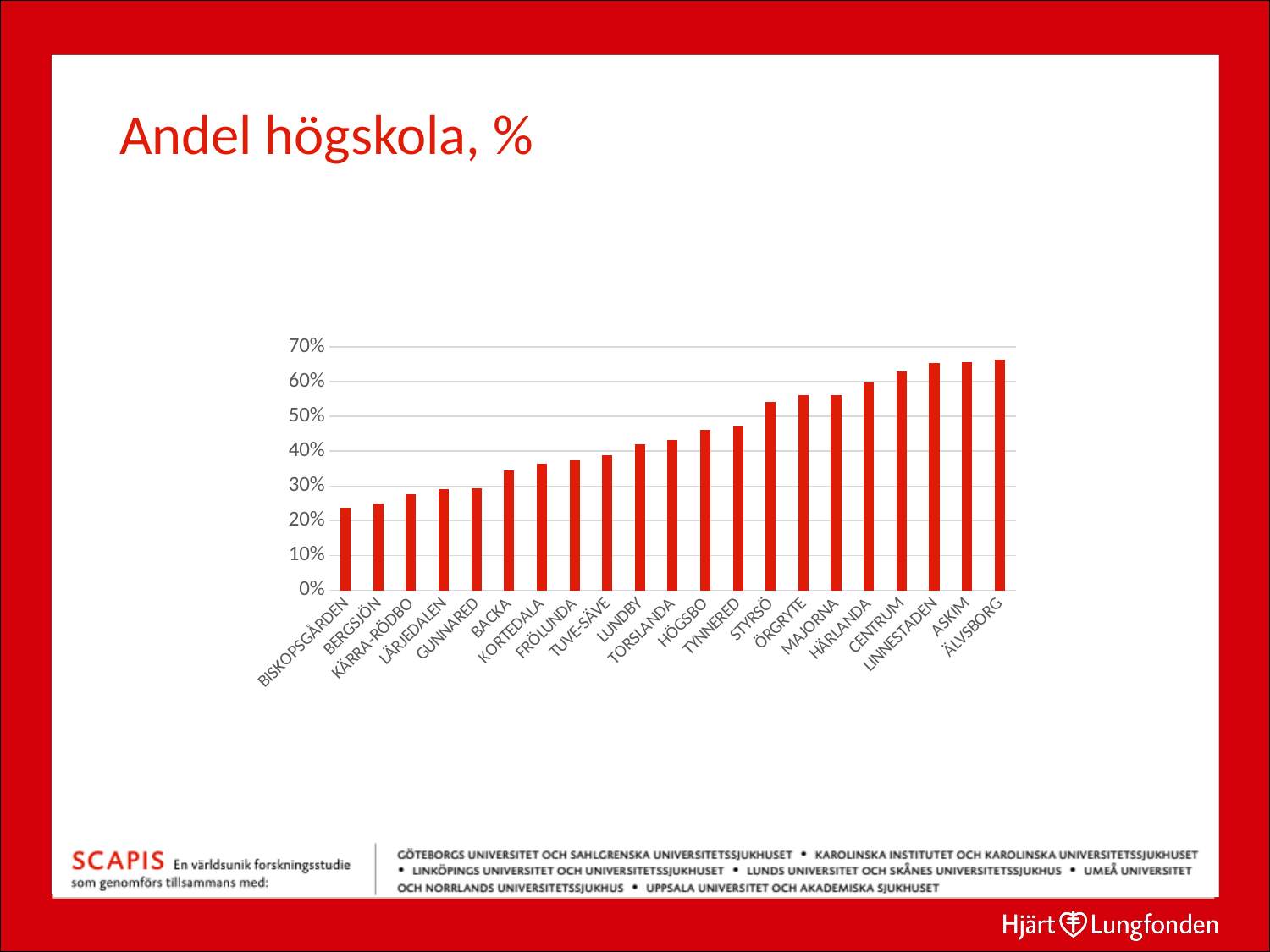
How many districts (bars) are shown in the chart? 21 Is the value for Tynnered greater or less than 50%? less What is the title of the chart? Andel högskola, % Is the value for Styrsö greater or less than 50%? greater What kind of chart is shown on the slide? Bar chart Do the values rise or fall from left to right along the x axis? Rise Which has a lower value, Kärra-Rödbo or Lundby? Kärra-Rödbo What colour are the bars in the chart? Red Is the value for Backa greater or less than 40%? less Which has a higher value, Centrum or Backa? Centrum